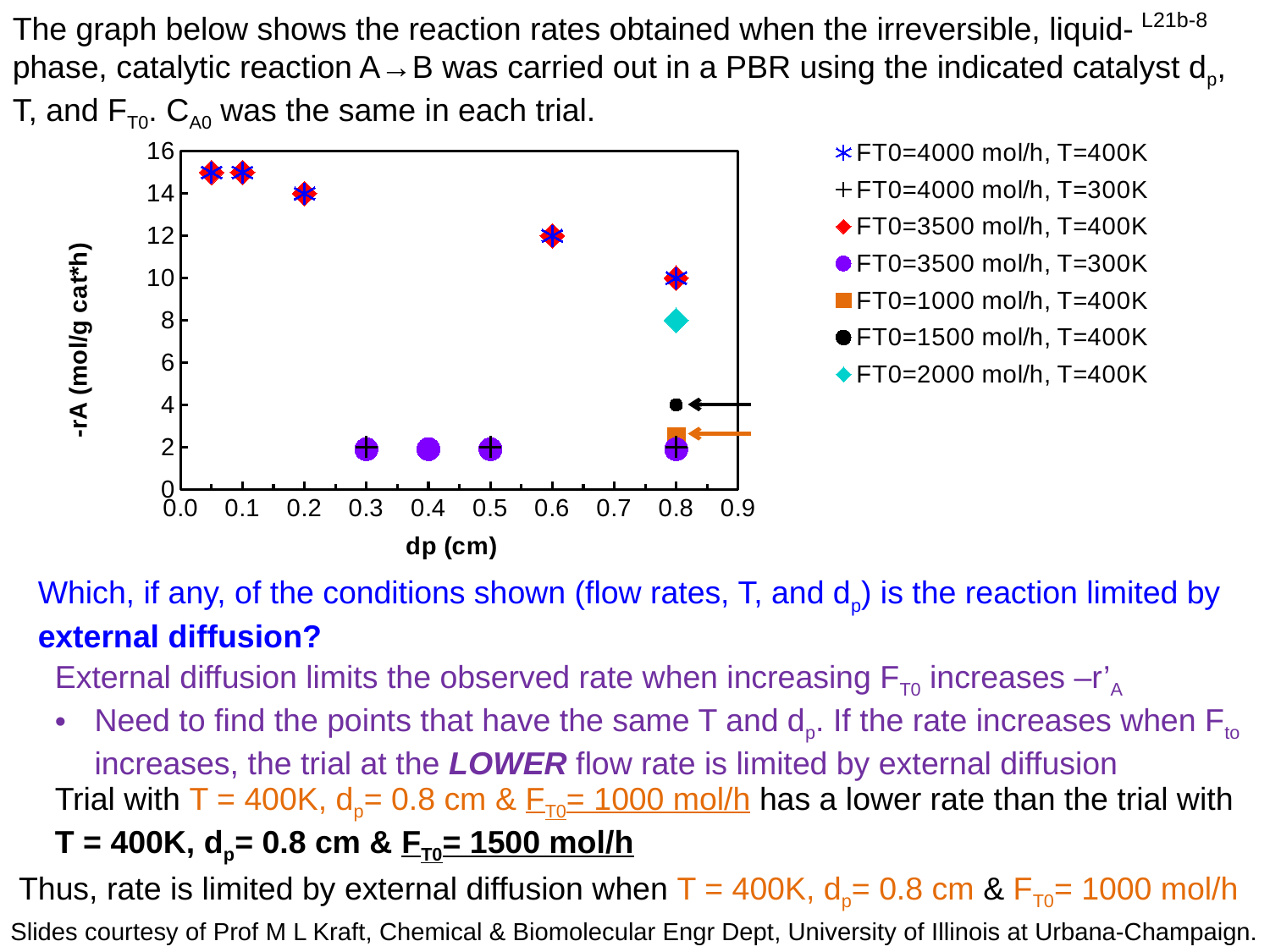
What is the reaction rate -rA for the FT0=4000 mol/h, T=400K trial at dp = 0.6 cm? 12 What is the reaction rate -rA for the FT0=1500 mol/h, T=400K trial at dp = 0.8 cm? 4 Is the reaction rate for the FT0=1000 mol/h, T=400K trial at dp = 0.8 cm greater or less than 4? less How many series does the legend list? 7 At dp = 0.8 cm, what is the difference in reaction rate between the FT0=2000 mol/h, T=400K trial and the FT0=1500 mol/h, T=400K trial? 4 What kind of chart is shown on the slide? scatter plot At dp = 0.8 cm, which has the higher reaction rate: the FT0=1500 mol/h, T=400K trial or the FT0=1000 mol/h, T=400K trial? FT0=1500 mol/h, T=400K For the FT0=4000 mol/h, T=400K series, does the reaction rate rise or fall as dp increases? falls What is the title of the y axis of the chart? -rA (mol/g cat*h) What is the reaction rate -rA for the FT0=2000 mol/h, T=400K trial at dp = 0.8 cm? 8 Is the reaction rate for the FT0=4000 mol/h, T=400K trial at dp = 0.05 cm greater or less than 14? greater